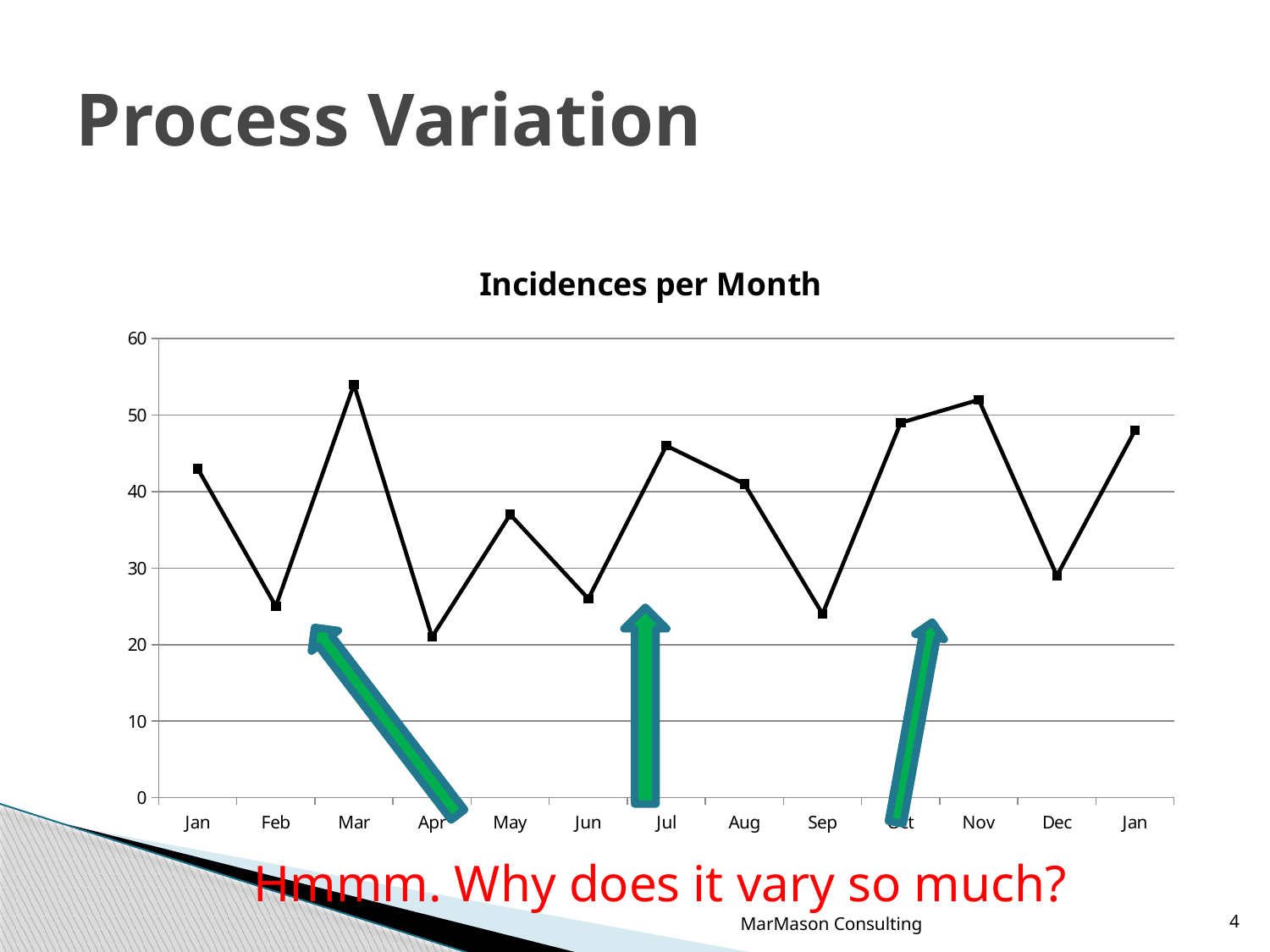
How many data points are plotted on the line? 13 Do the values rise or fall from Sep to Nov? rise Is the value for Sep greater or less than 30? less Is the value for Jul greater or less than 40? greater Which is larger, the value for Jun or the value for Jul? Jul Is the value for Mar greater or less than 50? greater What kind of chart is shown on the slide? line chart What is the title of the chart? Incidences per Month What is the highest value shown on the vertical axis? 60 Which is larger, the value for Mar or the value for Apr? Mar